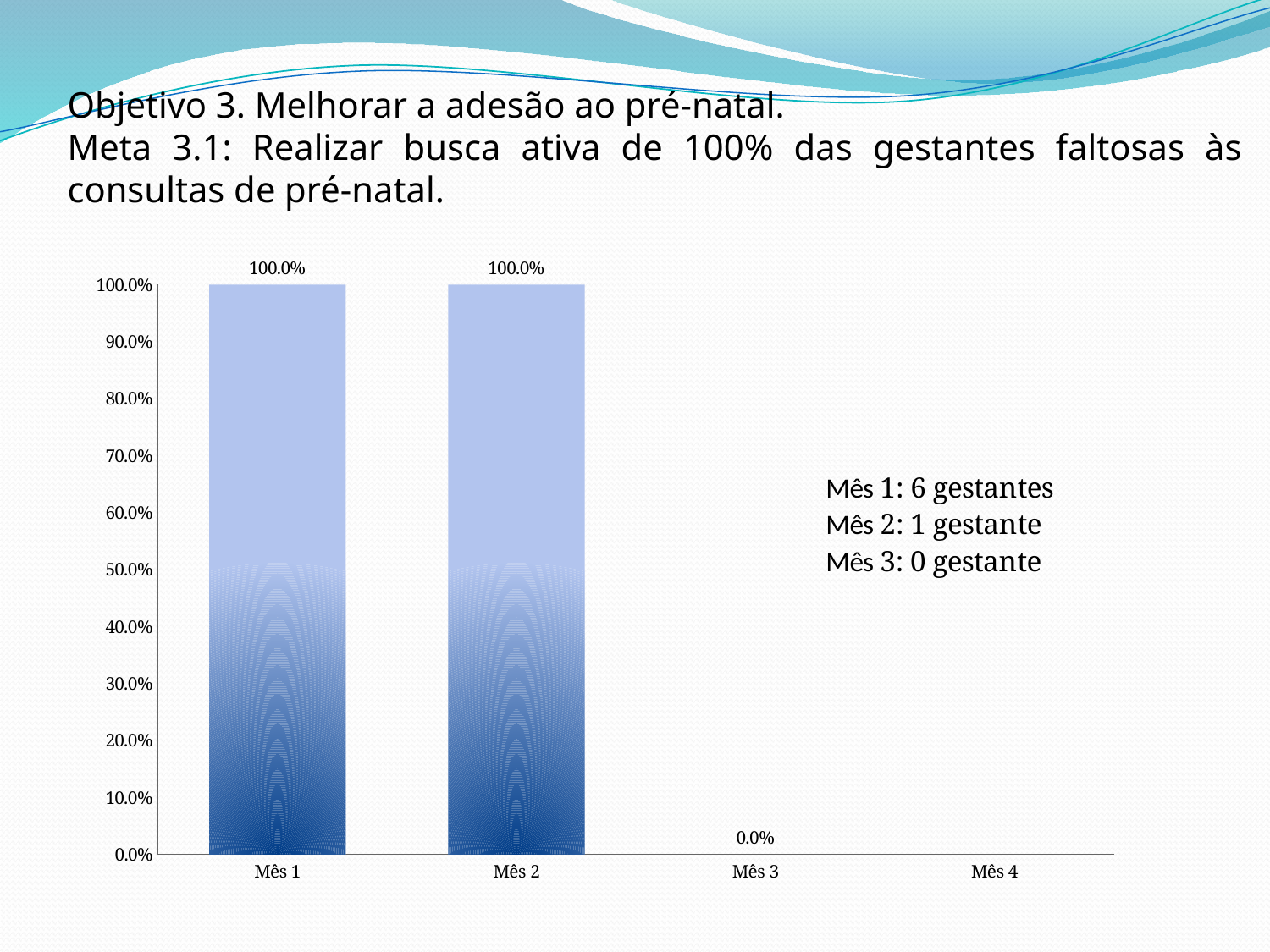
How many categories are shown on the x axis? 4 What is the value for Mês 2? 100.0% What is the difference between the values for Mês 1 and Mês 3? 100.0% Do the values rise or fall from Mês 2 to Mês 3? fall According to the text next to the chart, how many gestantes are listed for Mês 1? 6 gestantes What kind of chart is shown on the slide? bar chart Is the value for Mês 3 greater or less than 10.0%? less What is the highest value shown on the y axis? 100.0% What is the value for Mês 3? 0.0% Which is larger, the value for Mês 2 or the value for Mês 3? Mês 2 What is the value for Mês 1? 100.0% Is the value for Mês 1 greater or less than 50.0%? greater